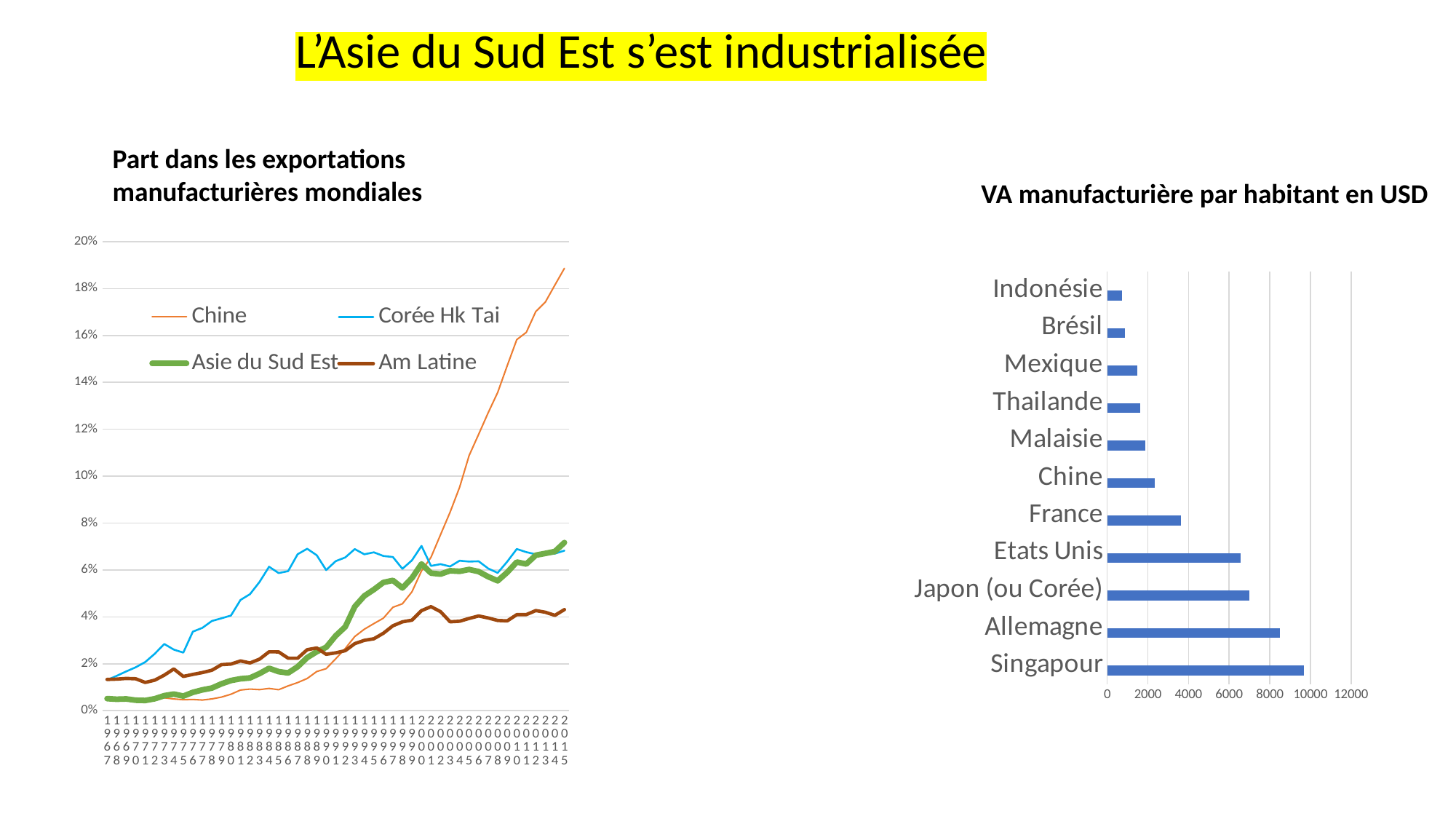
In the chart titled "VA manufacturière par habitant en USD", is the value for Singapour greater or less than 8000? greater What kind of chart is the chart titled "VA manufacturière par habitant en USD"? bar chart In the chart titled "VA manufacturière par habitant en USD", is the value for France greater or less than 4000? less In the chart titled "VA manufacturière par habitant en USD", which country has the highest value? Singapour In the chart titled "VA manufacturière par habitant en USD", is the value for Chine greater or less than 4000? less In the chart titled "VA manufacturière par habitant en USD", which is larger, the value for Allemagne or the value for France? Allemagne How many series does the legend list in the chart titled "Part dans les exportations manufacturières mondiales"? 4 In the chart titled "VA manufacturière par habitant en USD", which is larger, the value for Malaisie or the value for Etats Unis? Etats Unis How many countries are shown in the chart titled "VA manufacturière par habitant en USD"? 11 In the chart titled "Part dans les exportations manufacturières mondiales", does the Chine series rise or fall overall from 1967 to 2015? rise What kind of chart is the chart titled "Part dans les exportations manufacturières mondiales"? line chart